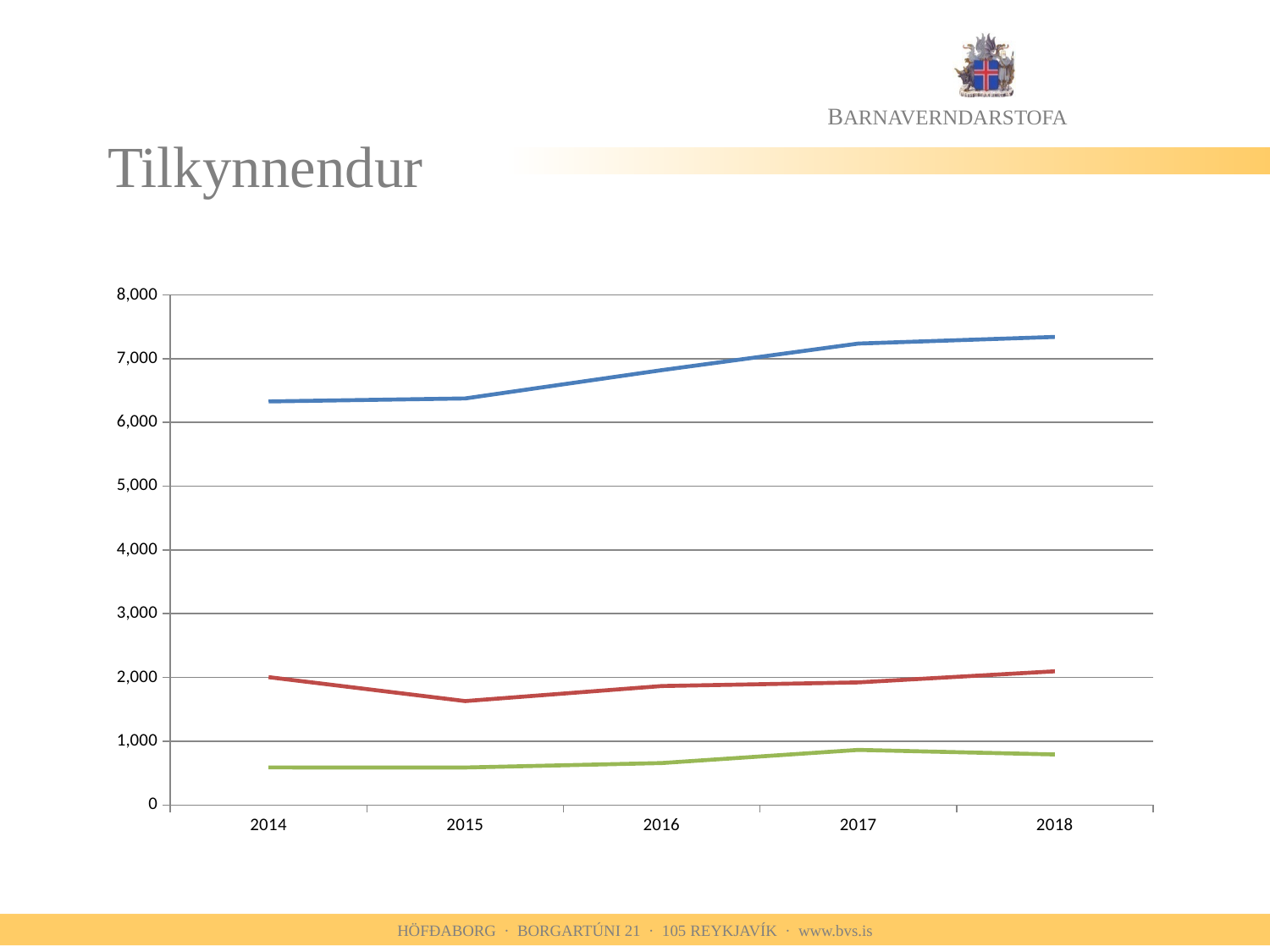
In which year is the green line at its highest? 2017 How many lines are plotted on the chart? 3 In which year is the red line at its lowest? 2015 How many years are shown along the x axis of the chart? 5 Is the value of the red line in 2015 greater or less than 2,000? less Does the blue line rise or fall from 2014 to 2018? rise Is the value of the blue line in 2014 greater or less than 6,000? greater What is the title of the chart on the slide? Tilkynnendur What kind of chart is shown on the slide? line chart In 2016, which line has the larger value, the blue line or the red line? the blue line Is the value of the green line in 2017 greater or less than 1,000? less